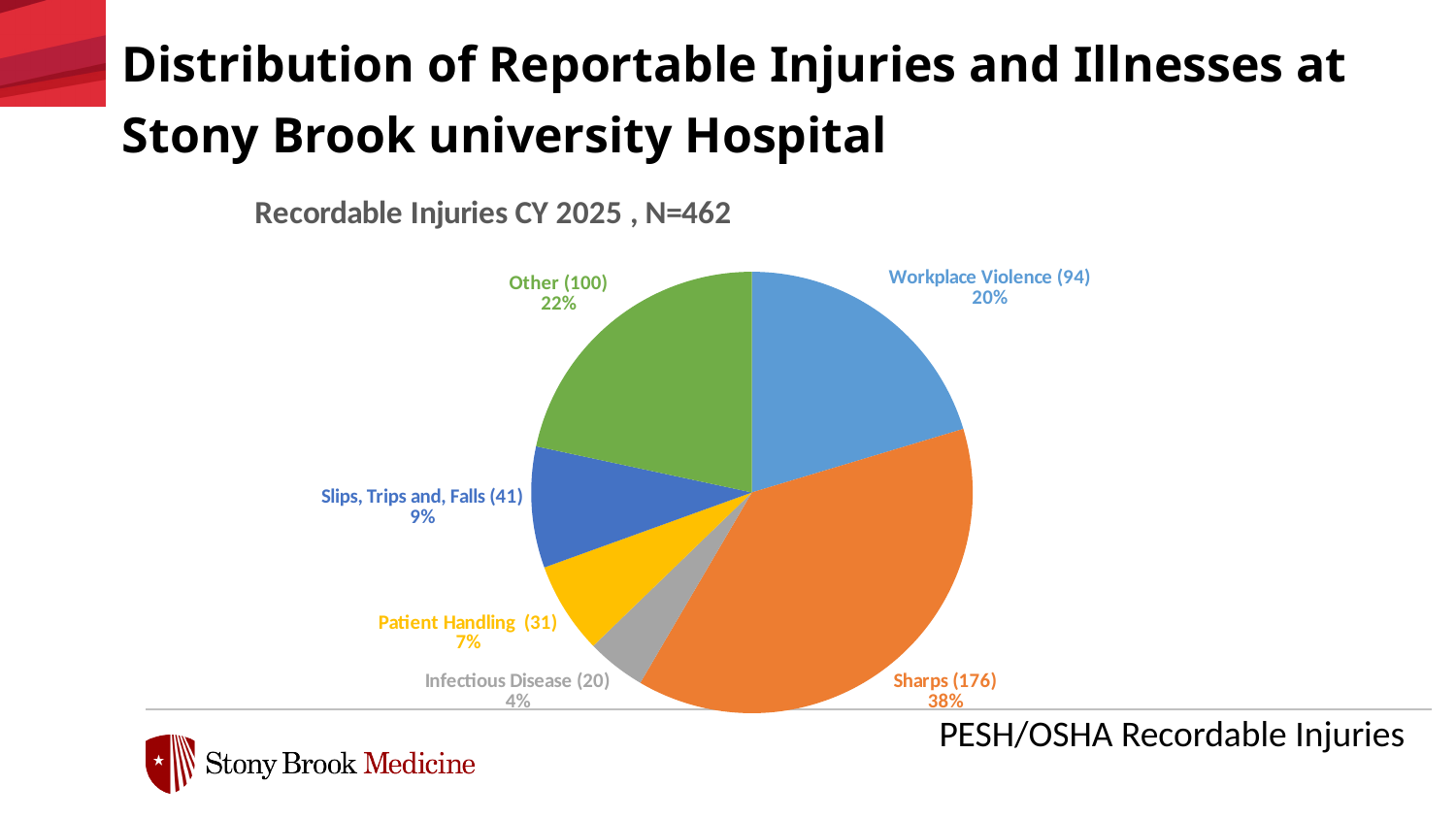
How many recordable injuries are attributed to Sharps? 176 Which category has the largest share of recordable injuries? Sharps What share of recordable injuries does the Other category represent? 22% What is the title of the chart? Recordable Injuries CY 2025 , N=462 What is the difference in count between Sharps and Other? 76 How many recordable injuries are in the Patient Handling category? 31 What type of chart is shown on the slide? pie chart Which has more recordable injuries, Slips, Trips and, Falls or Patient Handling? Slips, Trips and, Falls How many categories does the pie chart show? 6 What percentage of recordable injuries is Workplace Violence? 20% What is the total N of recordable injuries stated in the chart title? 462 Which category has the smallest share of recordable injuries? Infectious Disease